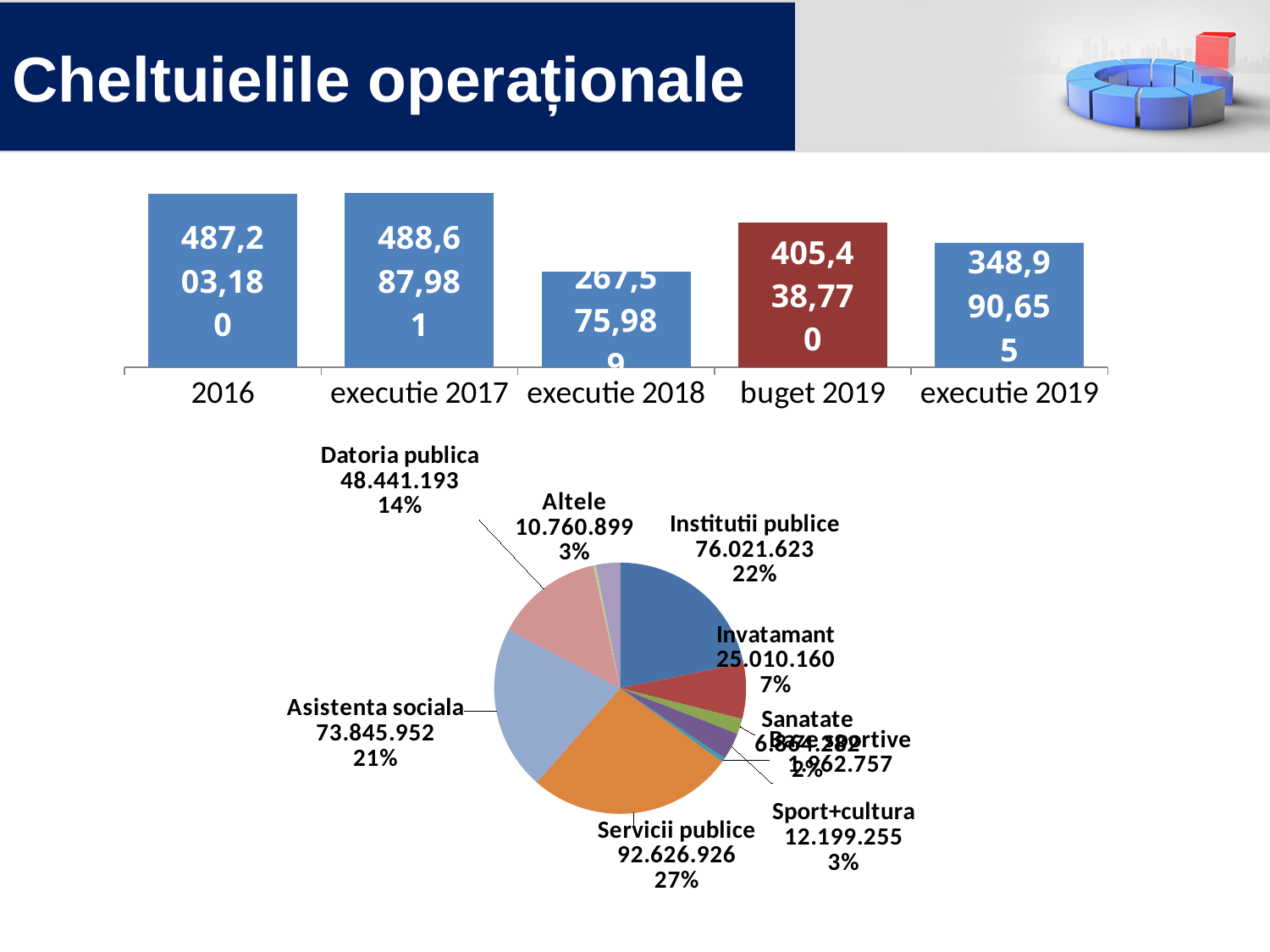
In the pie chart at the bottom of the slide, what is the difference between Servicii publice and Asistenta sociala? 18.780.974 In the pie chart at the bottom of the slide, which slice is the largest? Servicii publice In the bar chart at the top of the slide, what is the value for buget 2019? 405,438,770 In the bar chart at the top of the slide, how many categories are shown? 5 In the pie chart at the bottom of the slide, what is the value for Servicii publice? 92.626.926 In the bar chart at the top of the slide, which category has the lowest value? executie 2018 In the bar chart at the top of the slide, what is the difference between buget 2019 and executie 2019? 56,448,115 What kind of chart is the chart at the top of the slide? bar chart In the bar chart at the top of the slide, which category has the highest value? executie 2017 In the pie chart at the bottom of the slide, what share does Asistenta sociala represent? 21% In the bar chart at the top of the slide, what is the value for 2016? 487,203,180 In the bar chart at the top of the slide, what is the value for executie 2019? 348,990,655